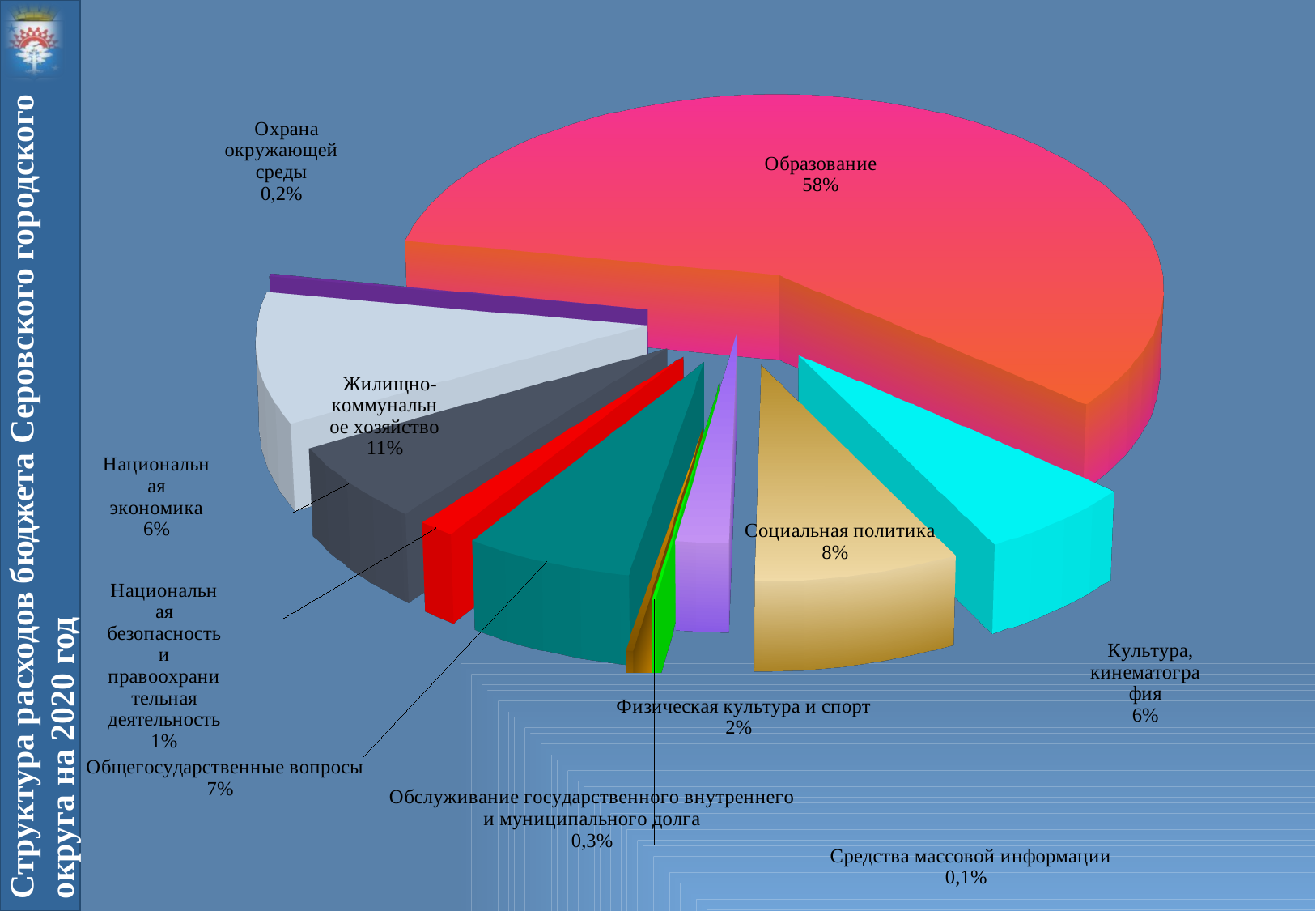
What share of the budget expenditure goes to Образование? 58% What is the value shown for Социальная политика? 8% How many categories are shown in the pie chart? 11 Which is larger, the share for Социальная политика or the share for Общегосударственные вопросы? Социальная политика What is the value shown for Жилищно-коммунальное хозяйство? 11% What is the difference between the shares of Образование and Жилищно-коммунальное хозяйство? 47% What is the value shown for Обслуживание государственного внутреннего и муниципального долга? 0,3% What is the difference between the shares of Физическая культура и спорт and Национальная безопасность и правоохранительная деятельность? 1% What is the title of the slide containing the chart? Структура расходов бюджета Серовского городского округа на 2020 год Which category has the smallest share of the pie? Средства массовой информации Which category has the largest share of the pie? Образование What kind of chart is shown on the slide? pie chart